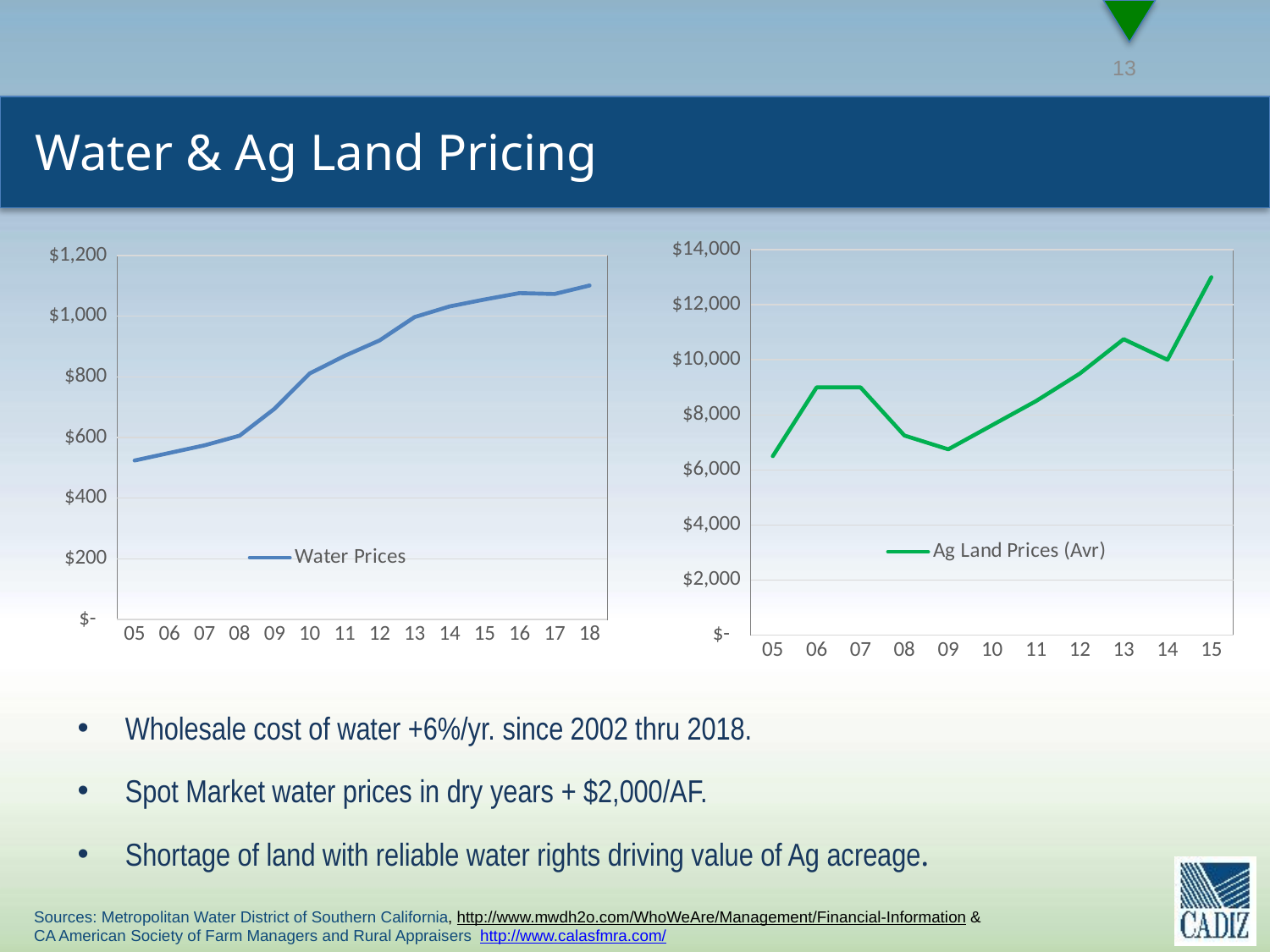
In the right 'Ag Land Prices (Avr)' chart, which year has the highest value? 15 In the right 'Ag Land Prices (Avr)' chart, is the value for 15 greater or less than $12,000? greater How many years are plotted on the x axis of the left 'Water Prices' chart? 14 In the right 'Ag Land Prices (Avr)' chart, which year has the higher value, 07 or 08? 07 In the left 'Water Prices' chart, is the value for 18 greater or less than $1,000? greater How many years are plotted on the x axis of the right 'Ag Land Prices (Avr)' chart? 11 In the left 'Water Prices' chart, is the value for 05 greater or less than $600? less In the left 'Water Prices' chart, do values generally rise or fall from 05 to 18? rise How many series does the legend of the right chart list? 1 In the left 'Water Prices' chart, which year has the highest value? 18 What type of chart is the left chart titled 'Water Prices'? line chart In the left 'Water Prices' chart, which year has the lowest value? 05